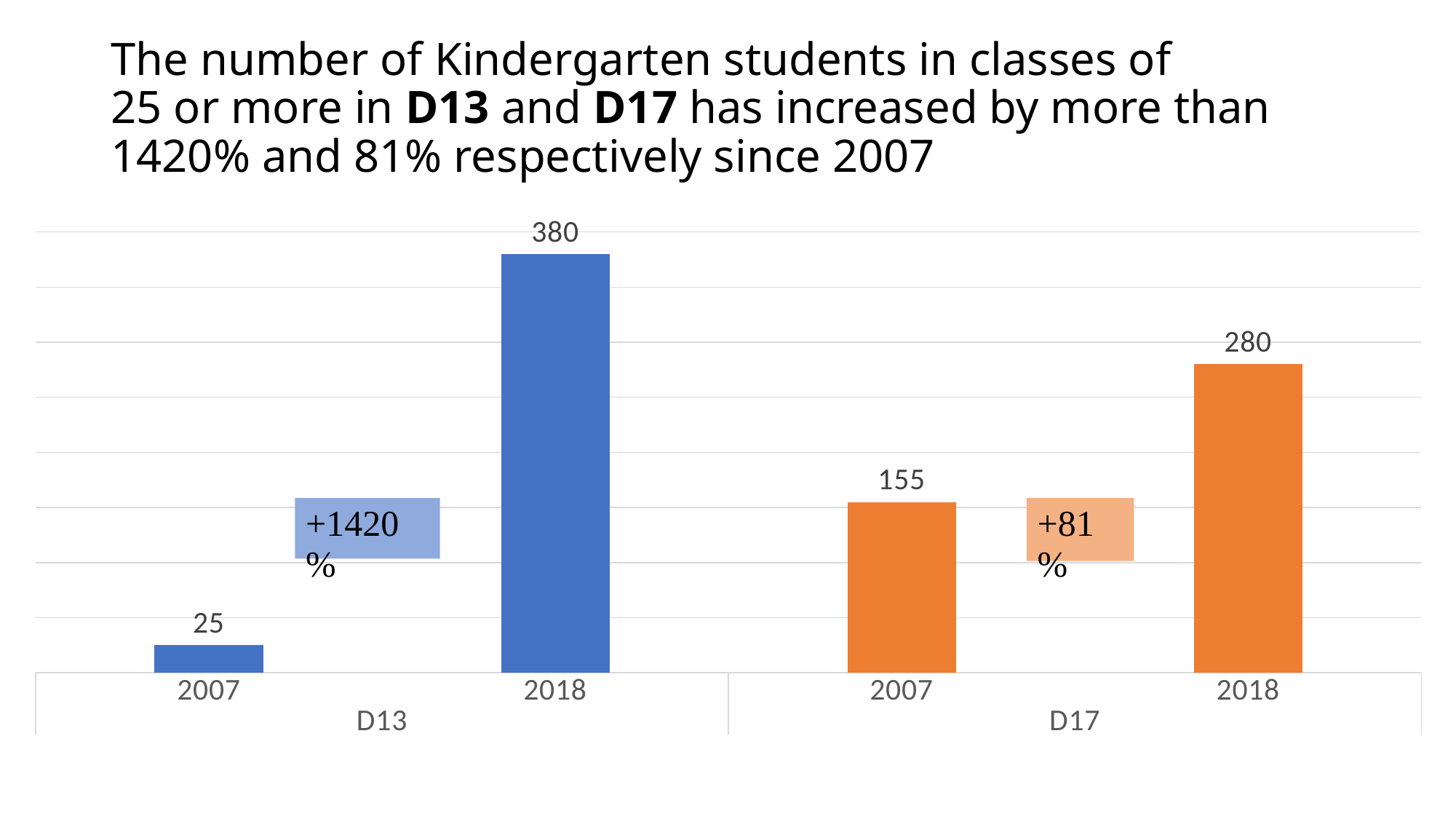
What is the difference between the D17 values for 2018 and 2007? 125 What is the value for D17 in 2018? 280 What is the value for D13 in 2007? 25 Which bar has the lowest value? D13 2007 How many bars are plotted on the chart? 4 What kind of chart is shown? bar chart What is the value for D13 in 2018? 380 What percentage increase is shown in the label between the D17 bars? +81% What is the difference between the D13 values for 2018 and 2007? 355 What is the value for D17 in 2007? 155 Which is larger, the 2018 value for D13 or the 2018 value for D17? D13 2018 Which bar has the highest value? D13 2018